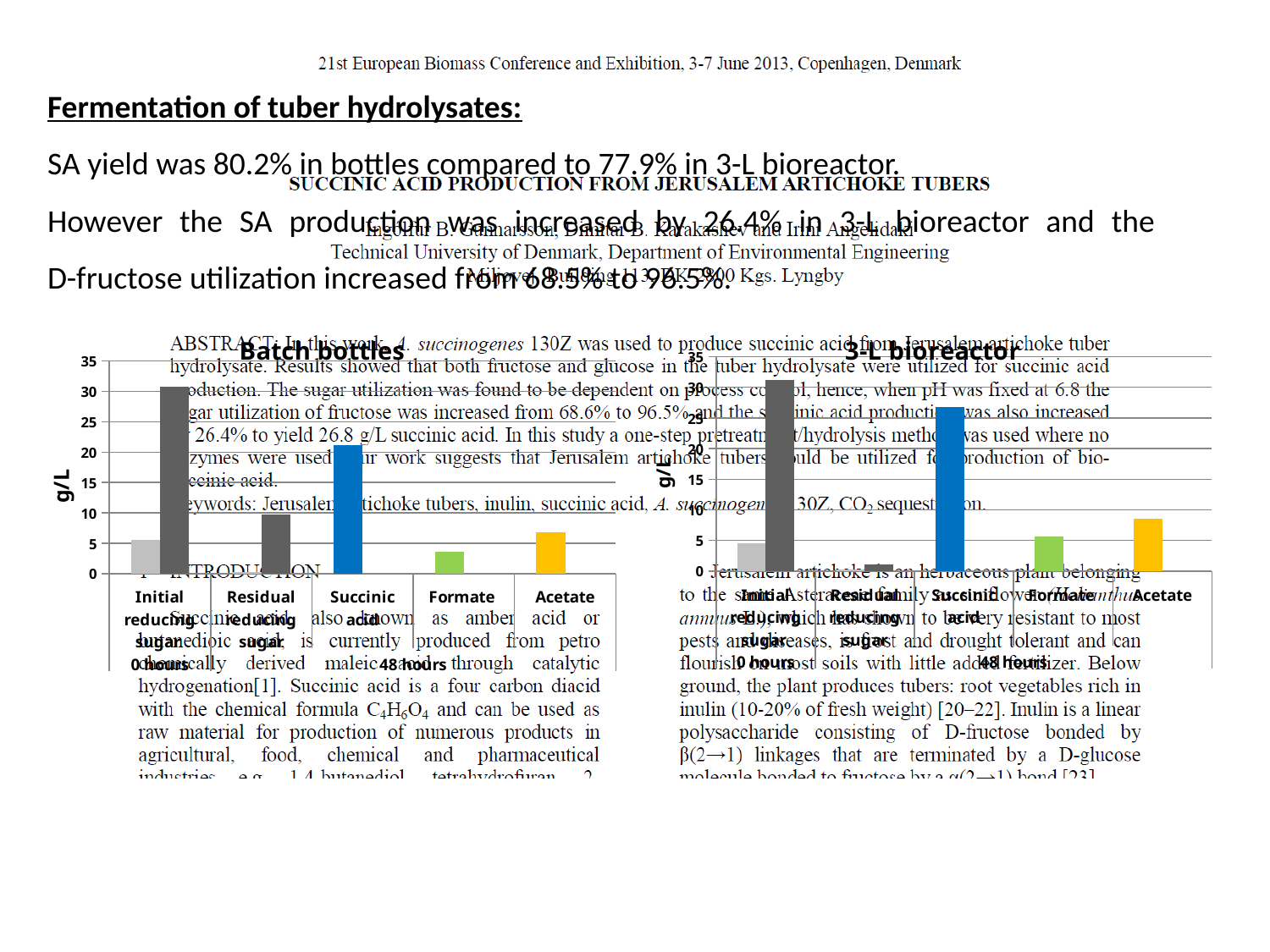
What type of chart is the "Batch bottles" chart? bar chart Is the Succinic acid bar higher in the "Batch bottles" chart or in the "3-L bioreactor" chart? 3-L bioreactor What is the title of the chart on the right side of the slide? 3-L bioreactor How many categories are shown on the x axis of the "3-L bioreactor" chart? 5 In the "Batch bottles" chart, is the value for Formate greater or less than 5? less In the "3-L bioreactor" chart, which category has the lowest bar? Residual reducing sugar 48 hours In the "3-L bioreactor" chart, is the value for Succinic acid greater or less than 25? greater In the "Batch bottles" chart, which category has the tallest bar? Initial reducing sugar 0 hours What is the y-axis label on the "Batch bottles" chart? g/L In the "Batch bottles" chart, is the value for Succinic acid greater or less than 15? greater In the "Batch bottles" chart, which is larger, Succinic acid or Acetate? Succinic acid